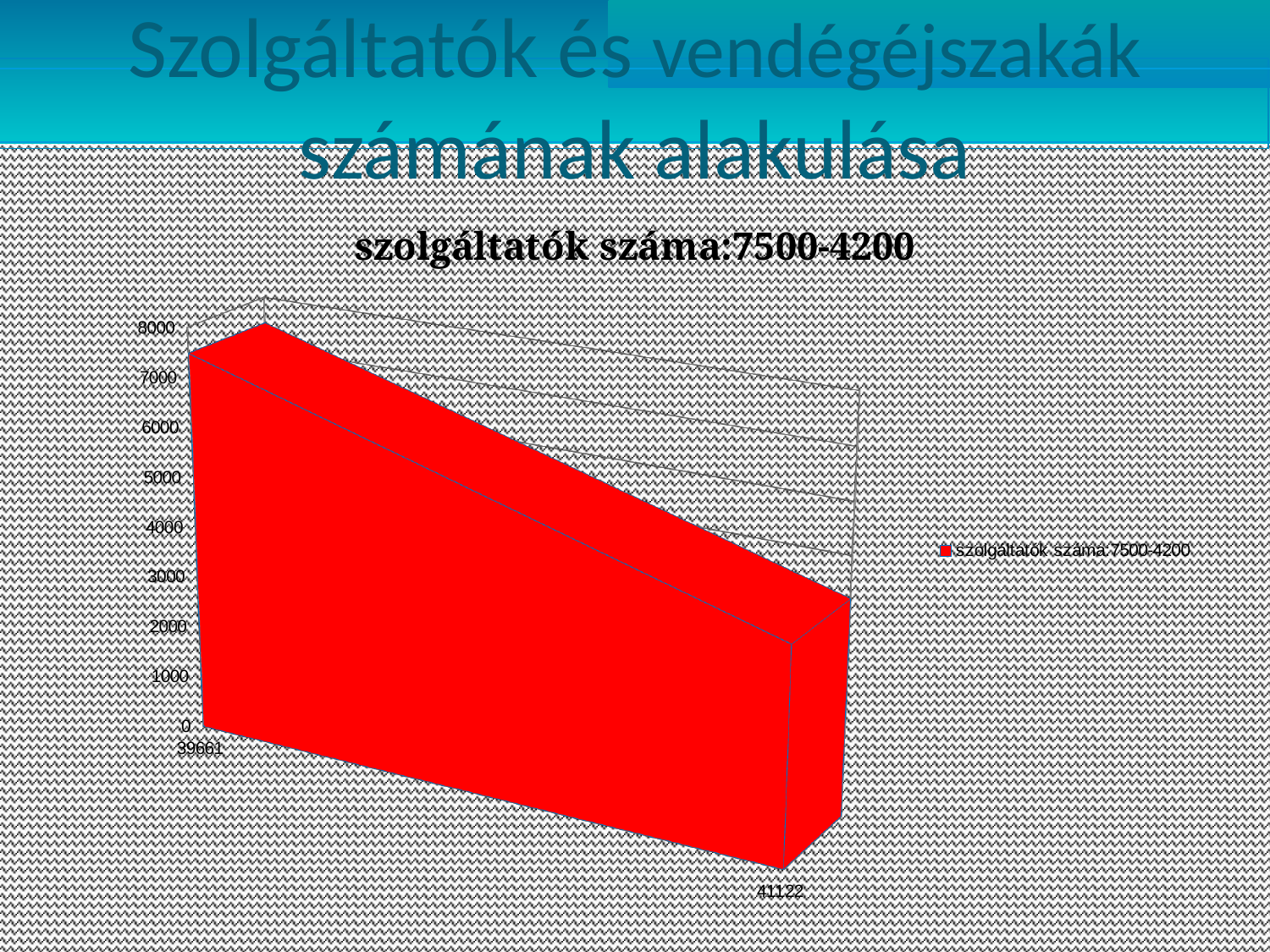
How many categories are shown on the x axis? 2 What colour is the plotted area in the chart? red Which is larger, the value for 39661 or the value for 41122? 39661 Which category has the lowest value? 41122 What kind of chart is shown on the slide? area chart Is the value for 41122 greater or less than 3000? greater Do the values rise or fall from 39661 to 41122? fall Is the value for 39661 greater or less than 7000? greater Is the value for 41122 greater or less than 5000? less Which category has the highest value? 39661 How many series does the legend list? 1 What is the title of the chart? szolgáltatók száma:7500-4200